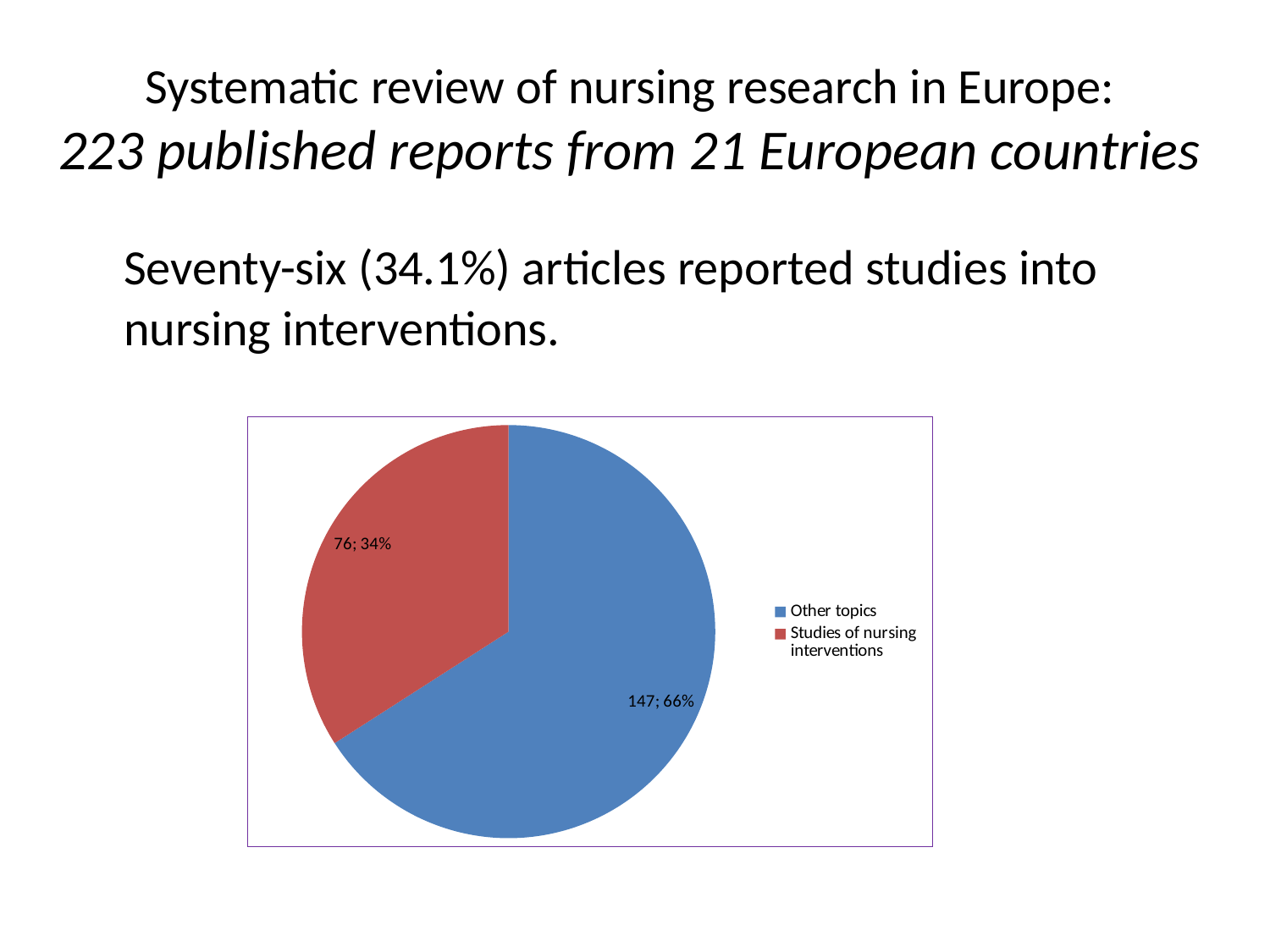
What percentage share of the pie is 'Studies of nursing interventions'? 34% What kind of chart is shown on the slide? pie chart Which slice of the pie chart is the largest? Other topics What is the difference between the counts for 'Other topics' and 'Studies of nursing interventions'? 71 Which slice of the pie chart is the smallest? Studies of nursing interventions Which is larger, the count for 'Other topics' or for 'Studies of nursing interventions'? Other topics How many entries does the legend of the pie chart list? 2 What percentage share of the pie is 'Other topics'? 66% How many slices does the pie chart have? 2 What is the count shown for the 'Studies of nursing interventions' slice? 76 What is the count shown for the 'Other topics' slice? 147 What colour is the 'Studies of nursing interventions' slice? red